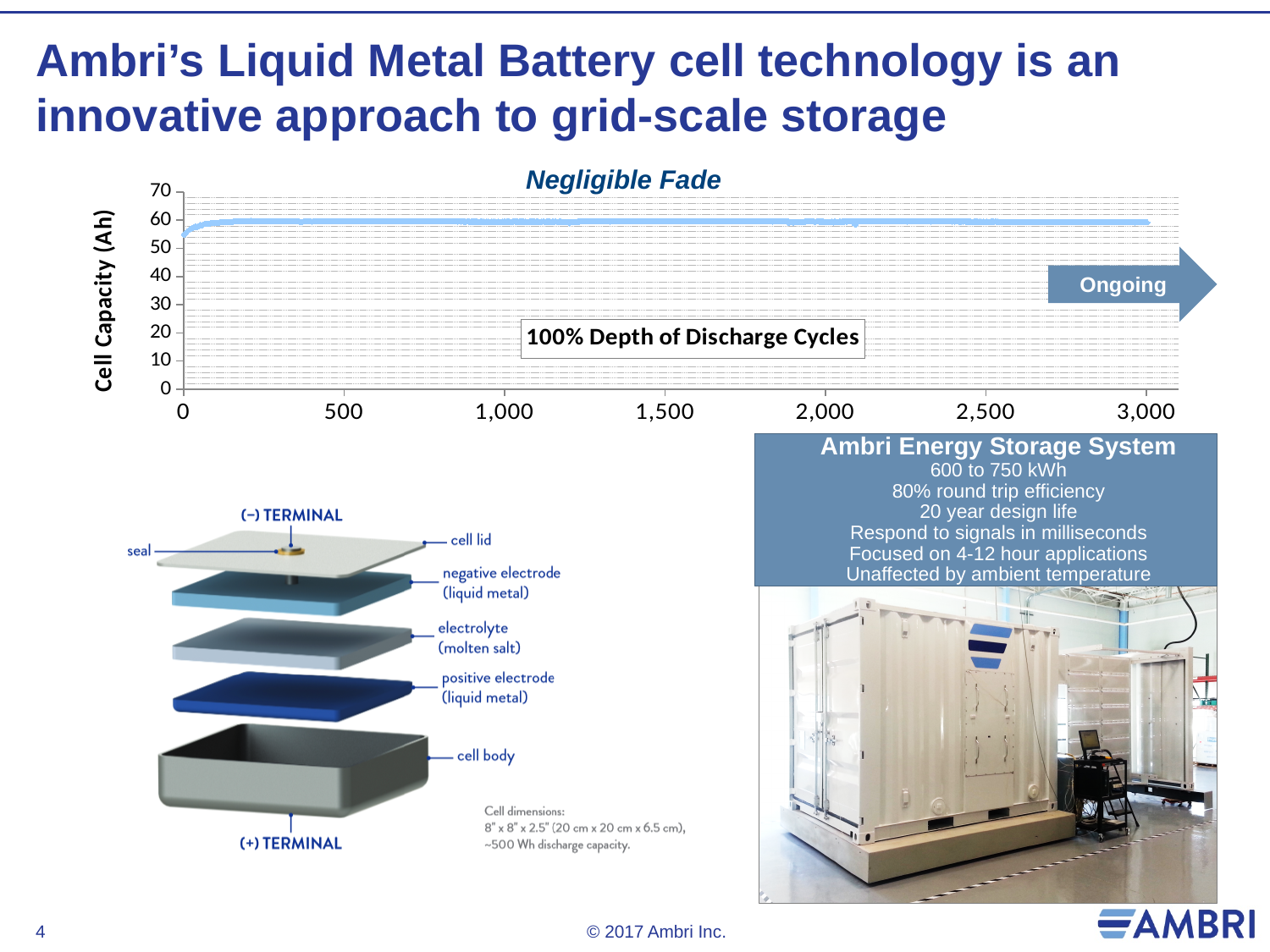
What is the label of the vertical axis of the chart? Cell Capacity (Ah) Is the cell capacity at 500 cycles greater or less than 30? greater Is the cell capacity at 3,000 cycles greater or less than 40? greater How does the cell capacity change as the number of cycles increases from 0 to 3,000? stays roughly flat Is the cell capacity at 1,000 cycles greater or less than 50? greater What is the title of the chart at the top of the slide? Negligible Fade What kind of chart is shown at the top of the slide? line chart